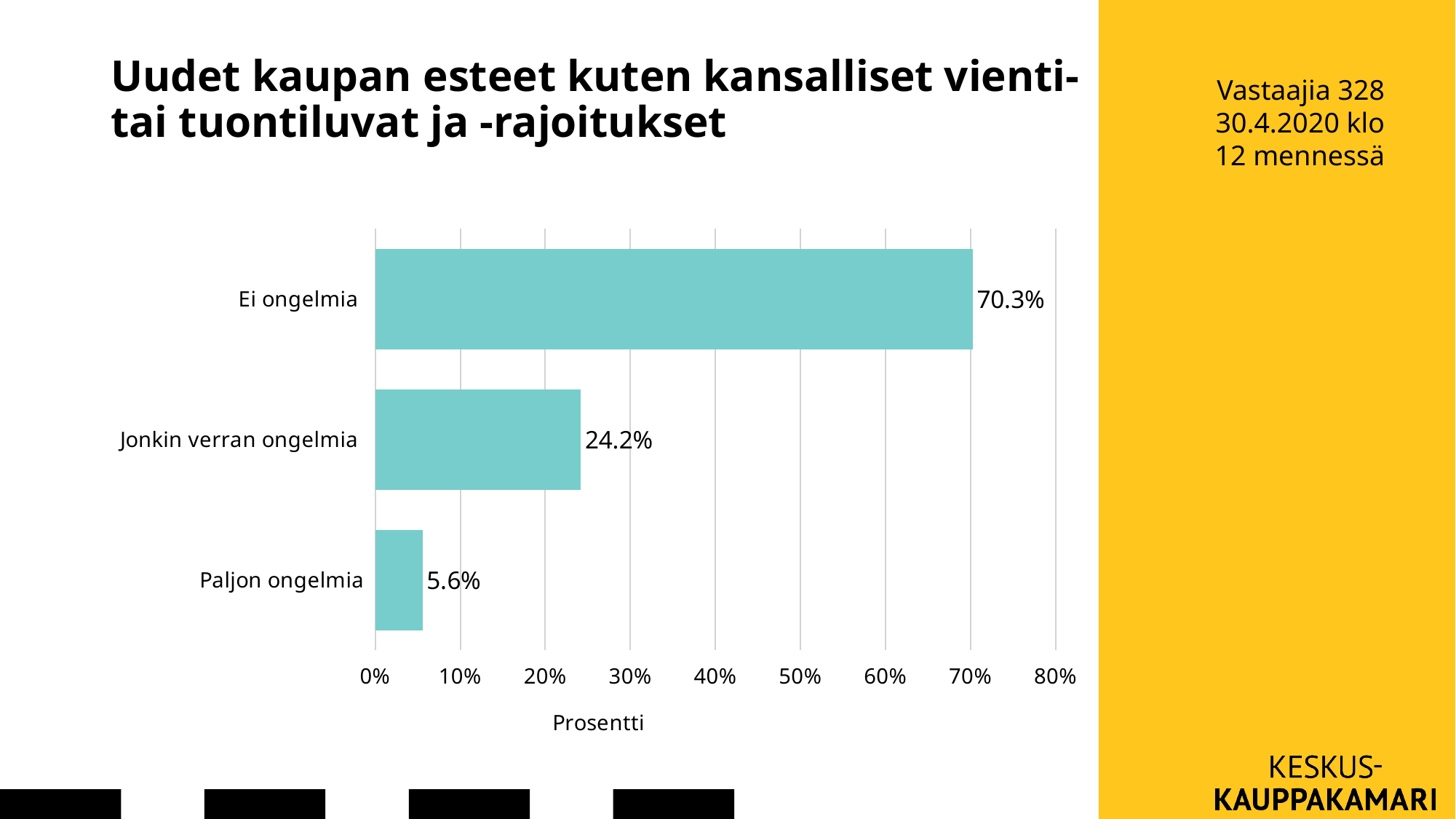
Which category has the highest value? Ei ongelmia What is the difference between the values for "Ei ongelmia" and "Jonkin verran ongelmia"? 46.1% Which is larger, the value for "Jonkin verran ongelmia" or the value for "Paljon ongelmia"? Jonkin verran ongelmia Which category has the lowest value? Paljon ongelmia What kind of chart is shown on the slide? Bar chart What is the difference between the values for "Jonkin verran ongelmia" and "Paljon ongelmia"? 18.6% How many categories are shown in the chart? 3 What is the label of the horizontal axis? Prosentti What is the value for "Jonkin verran ongelmia"? 24.2% Is the value for "Ei ongelmia" greater or less than 60%? greater What is the value for "Paljon ongelmia"? 5.6% What is the value for "Ei ongelmia"? 70.3%